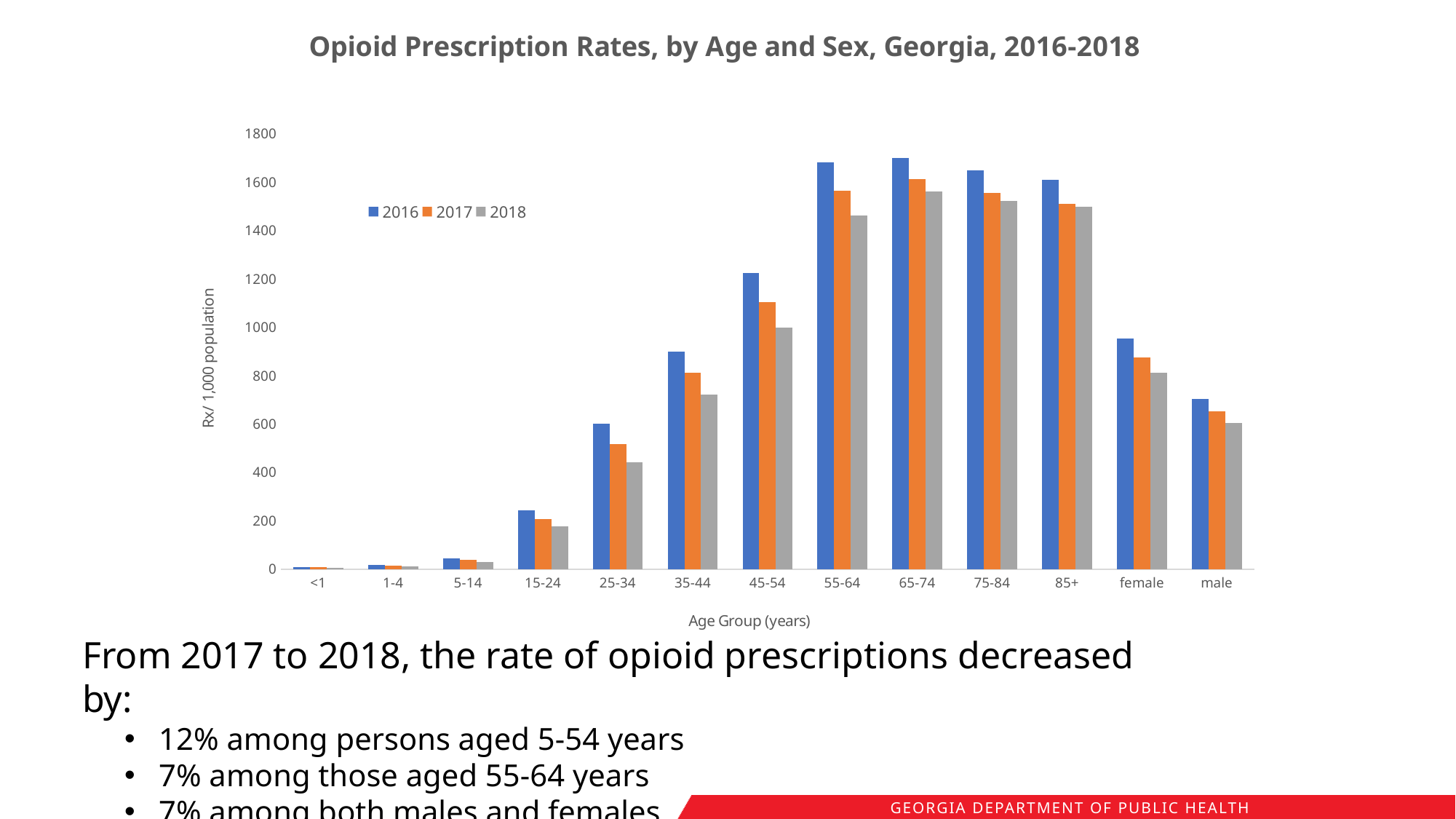
For the 55-64 age group, which year has the larger value, 2016 or 2018? 2016 Within each age group, do the values rise or fall from 2016 to 2018? fall Is the 2016 value for the 45-54 age group greater or less than 1000? greater Is the 2018 value for male greater or less than 400? greater What kind of chart is shown on the slide? bar chart Is the 2018 value for the 25-34 age group greater or less than 600? less How many series does the legend list? 3 What is the label of the y axis? Rx/ 1,000 population Which age group has the lowest opioid prescription rate in 2016? <1 Which is larger in 2018, the value for female or the value for male? female How many categories are shown on the x axis? 13